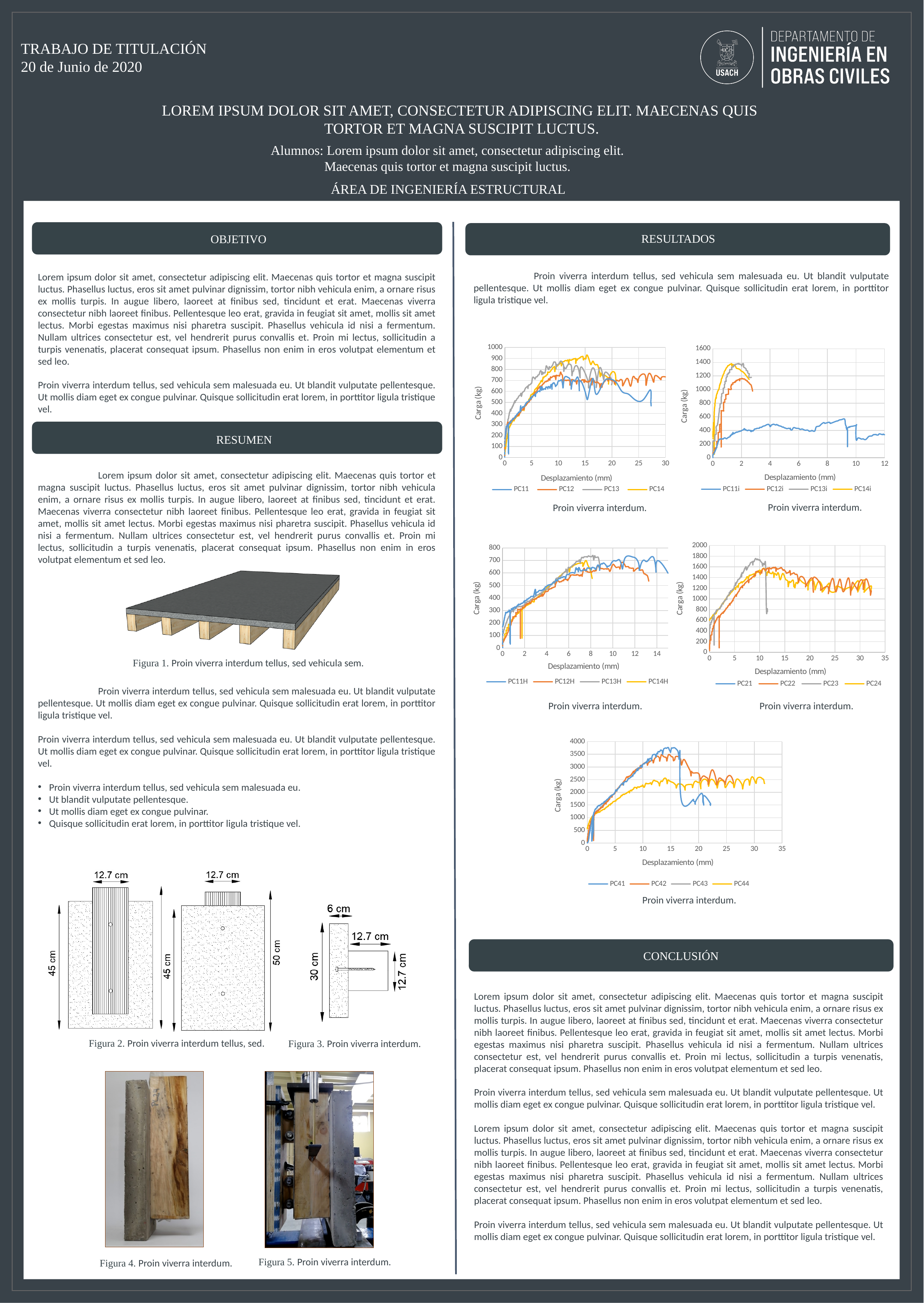
What is the y-axis label of the top-right chart (PC11i to PC14i)? Carga (kg) What is the x-axis label of the bottom chart (PC41 to PC44)? Desplazamiento (mm) In the bottom chart (PC41 to PC44), is the peak value of PC41 greater or less than 3000? greater In the top-right chart (PC11i to PC14i), is the peak value of PC11i greater or less than 1000? less In the bottom chart (PC41 to PC44), is the peak value of PC44 greater or less than 3000? less How many series does the legend of the bottom chart (PC41 to PC44) list? 4 What kind of chart is the top-left chart in the Resultados section (legend PC11 to PC14)? line chart In the top-right chart (PC11i to PC14i), which series reaches a higher peak load, PC11i or PC14i? PC14i In the bottom chart (PC41 to PC44), which series reaches the lowest peak load? PC44 In the top-right chart (PC11i to PC14i), which series reaches the lowest peak load? PC11i How many series does the legend of the top-left chart (PC11 to PC14) list? 4